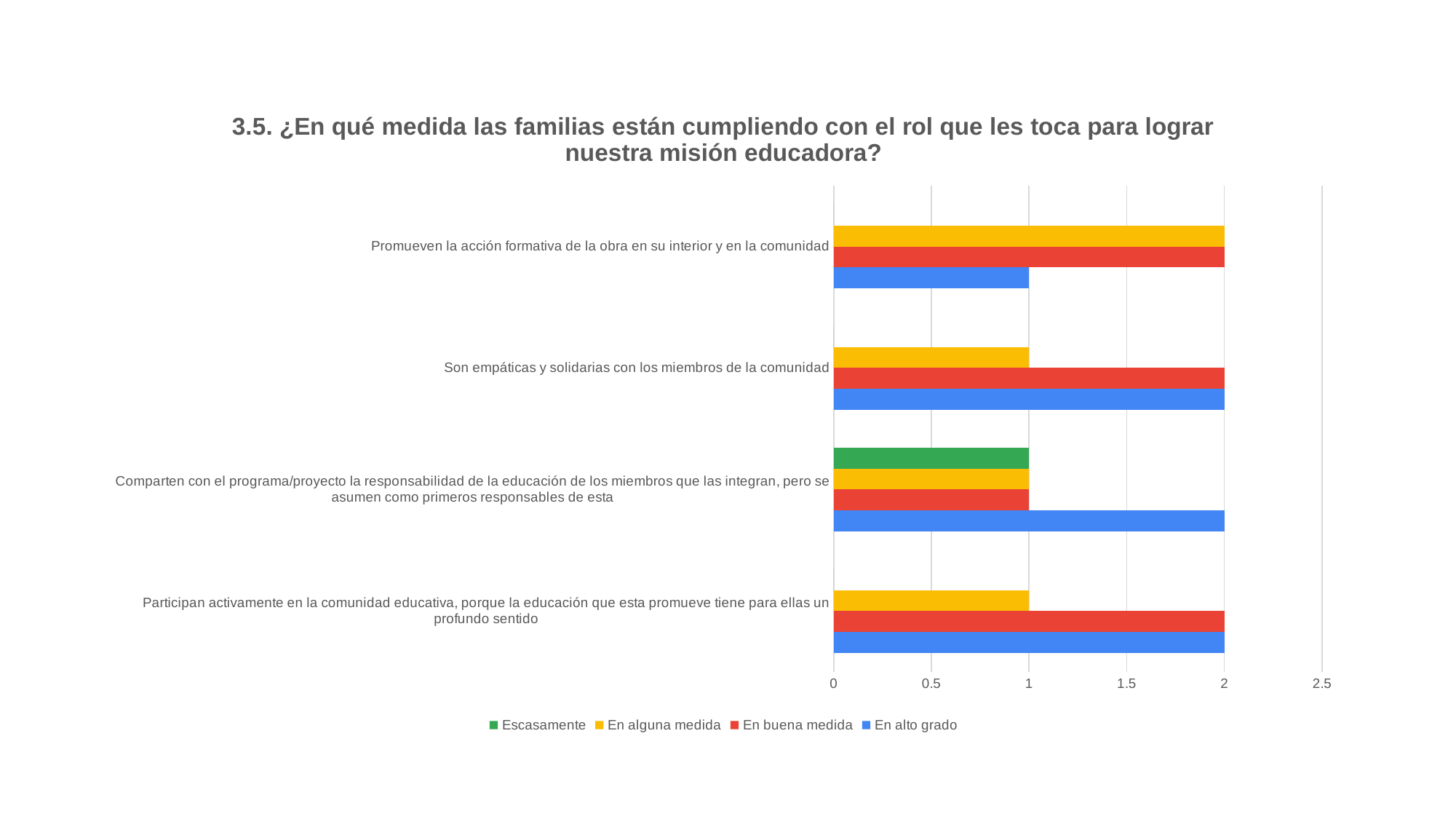
What is the difference between 'En alto grado' and 'En alguna medida' for 'Son empáticas y solidarias con los miembros de la comunidad'? 1 What is the value of 'En alto grado' for 'Comparten con el programa/proyecto la responsabilidad de la educación de los miembros que las integran, pero se asumen como primeros responsables de esta'? 2 What is the value of 'En alto grado' for 'Promueven la acción formativa de la obra en su interior y en la comunidad'? 1 For 'Promueven la acción formativa de la obra en su interior y en la comunidad', which is larger: 'En buena medida' or 'En alto grado'? En buena medida What kind of chart is shown on the slide? Bar chart How many categories are plotted on the chart? 4 What is the value of 'En buena medida' for 'Participan activamente en la comunidad educativa, porque la educación que esta promueve tiene para ellas un profundo sentido'? 2 Which series is shown in blue in the legend? En alto grado How many series does the legend list? 4 What is the value of 'En alguna medida' for 'Son empáticas y solidarias con los miembros de la comunidad'? 1 What is the value of 'Escasamente' for 'Comparten con el programa/proyecto la responsabilidad de la educación de los miembros que las integran, pero se asumen como primeros responsables de esta'? 1 Which category is the only one with a bar for 'Escasamente'? Comparten con el programa/proyecto la responsabilidad de la educación de los miembros que las integran, pero se asumen como primeros responsables de esta